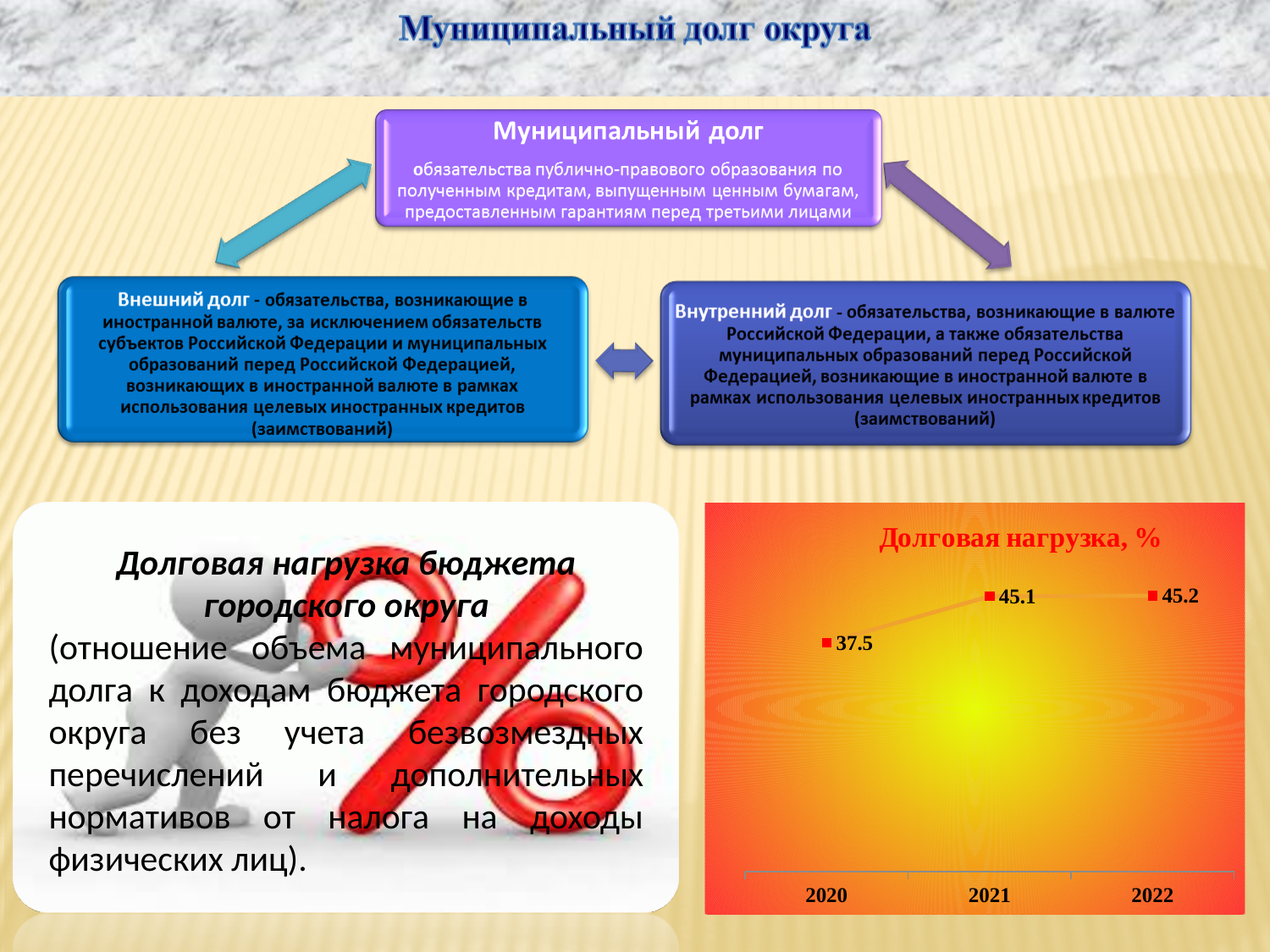
What kind of chart is shown on the slide? line chart How many years are plotted in the chart? 3 What is the value for 2021 in the chart? 45.1 What is the difference between the values for 2022 and 2021? 0.1 What is the difference between the values for 2021 and 2020? 7.6 Which year has the highest value in the chart? 2022 Do the values rise or fall from 2020 to 2022? rise Which year has the lowest value in the chart? 2020 What is the title of the chart? Долговая нагрузка, % Which is larger, the value for 2020 or the value for 2021? 2021 What is the value for 2022 in the chart? 45.2 What is the value for 2020 in the chart? 37.5